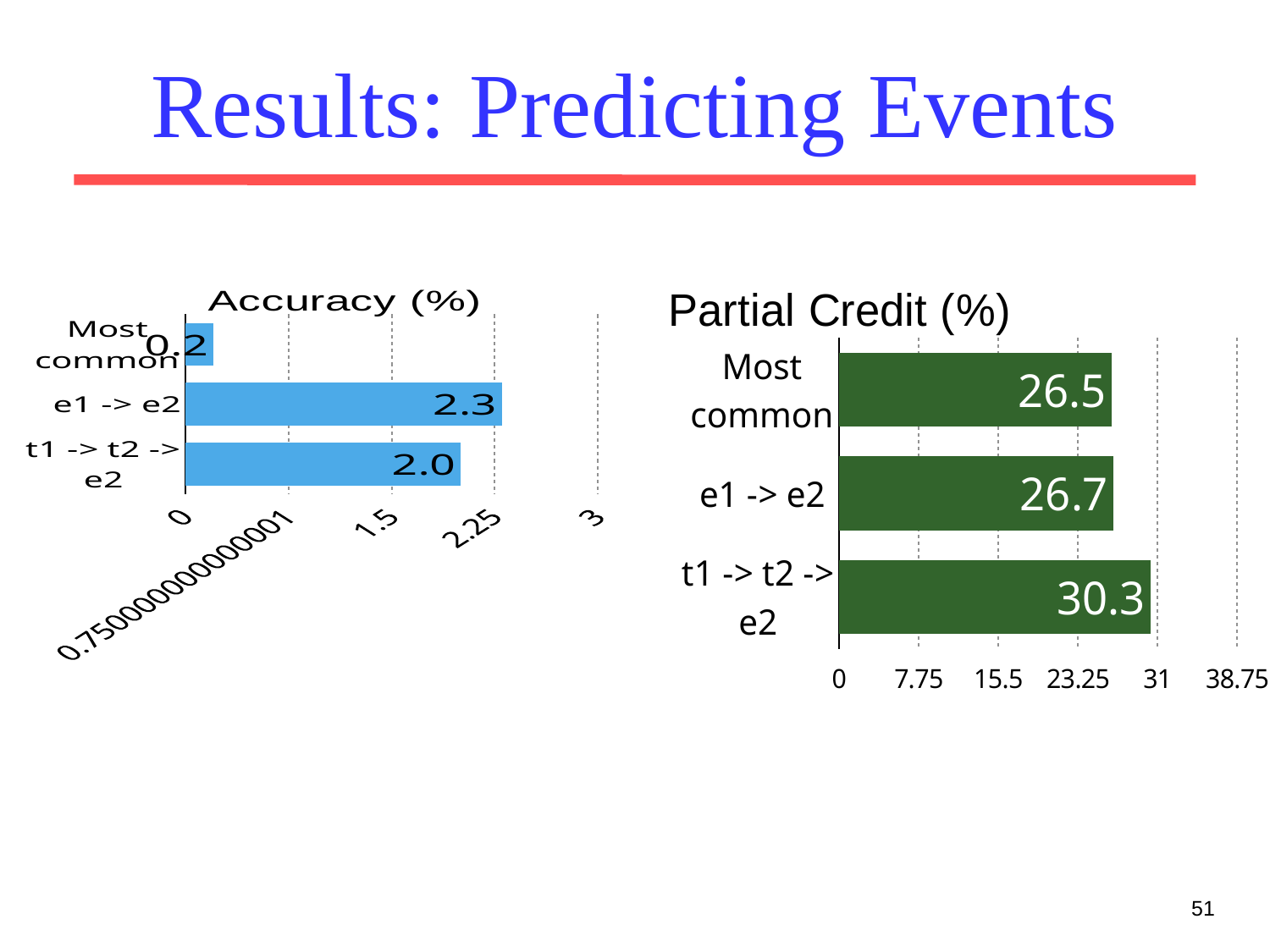
In the Partial Credit (%) chart, what is the difference between t1 -> t2 -> e2 and Most common? 3.8 In the Accuracy (%) chart, which category has the highest value? e1 -> e2 In the Accuracy (%) chart, what is the value for e1 -> e2? 2.3 In the Partial Credit (%) chart, what is the value for Most common? 26.5 In the Partial Credit (%) chart, which is larger, e1 -> e2 or Most common? e1 -> e2 In the Partial Credit (%) chart, which category has the highest value? t1 -> t2 -> e2 In the Accuracy (%) chart, what is the value for Most common? 0.2 In the Accuracy (%) chart, which category has the lowest value? Most common What kind of chart is the Accuracy (%) chart? Bar chart How many categories does the Partial Credit (%) chart show? 3 In the Partial Credit (%) chart, what is the value for t1 -> t2 -> e2? 30.3 In the Accuracy (%) chart, what is the difference between e1 -> e2 and t1 -> t2 -> e2? 0.3